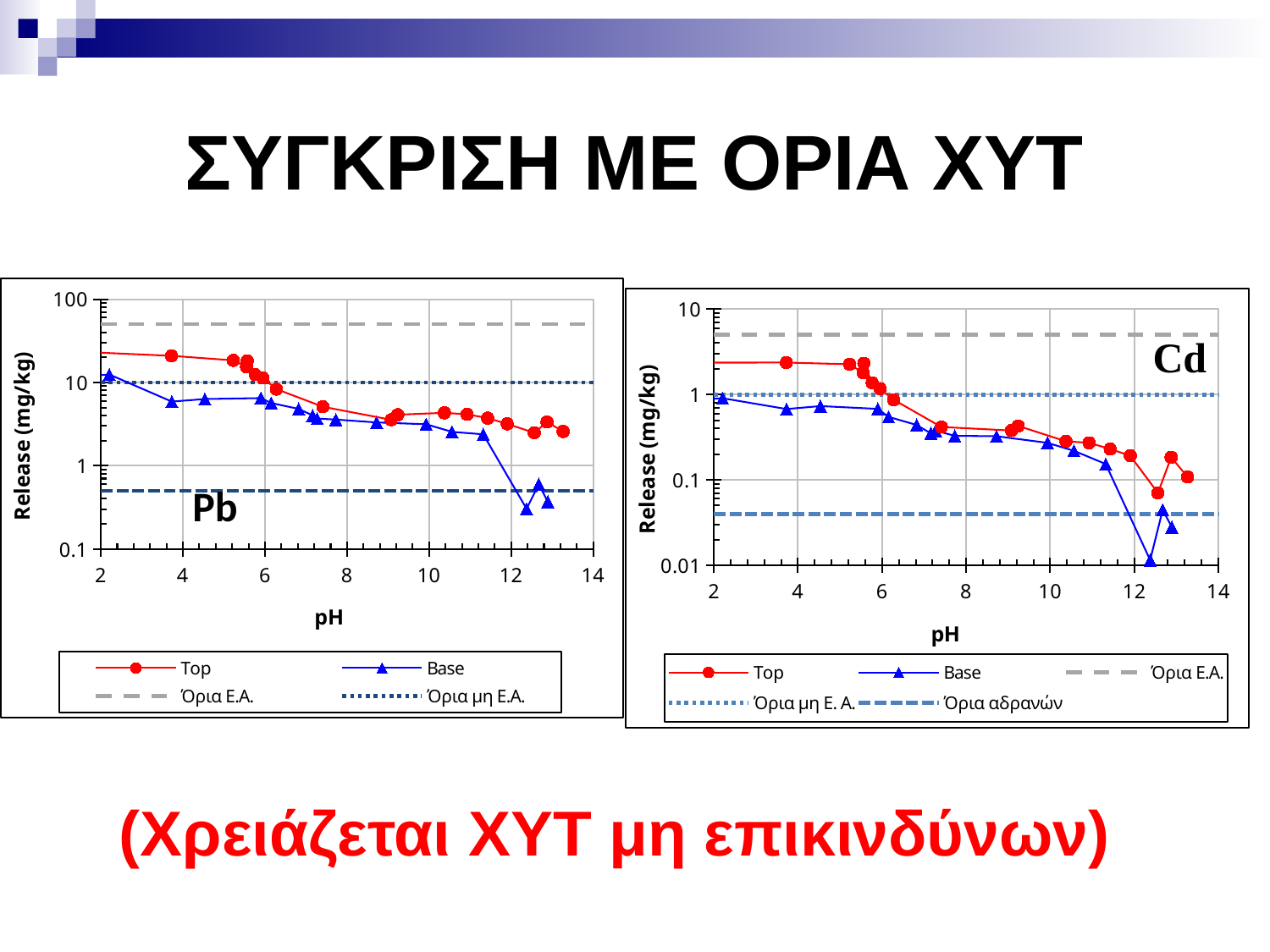
In the Pb chart, at pH 2, which series has the higher release, Top or Base? Top In the Pb chart, does the Top series generally rise or fall as pH increases? fall What kind of chart is the Pb chart on the left? line chart How many entries does the legend of the Pb chart list? 4 What is the label of the y axis on both charts? Release (mg/kg) In the Cd chart, is the Base value at about pH 12.4 greater or less than 0.1 mg/kg? less In the Cd chart, is the Top value at pH 2 greater or less than 1 mg/kg? greater In the Cd chart, does the Top series generally rise or fall as pH increases? fall In the Pb chart, is the Top value at pH 2 greater or less than 10 mg/kg? greater How many entries does the legend of the Cd chart list? 5 What kind of chart is the Cd chart on the right? line chart